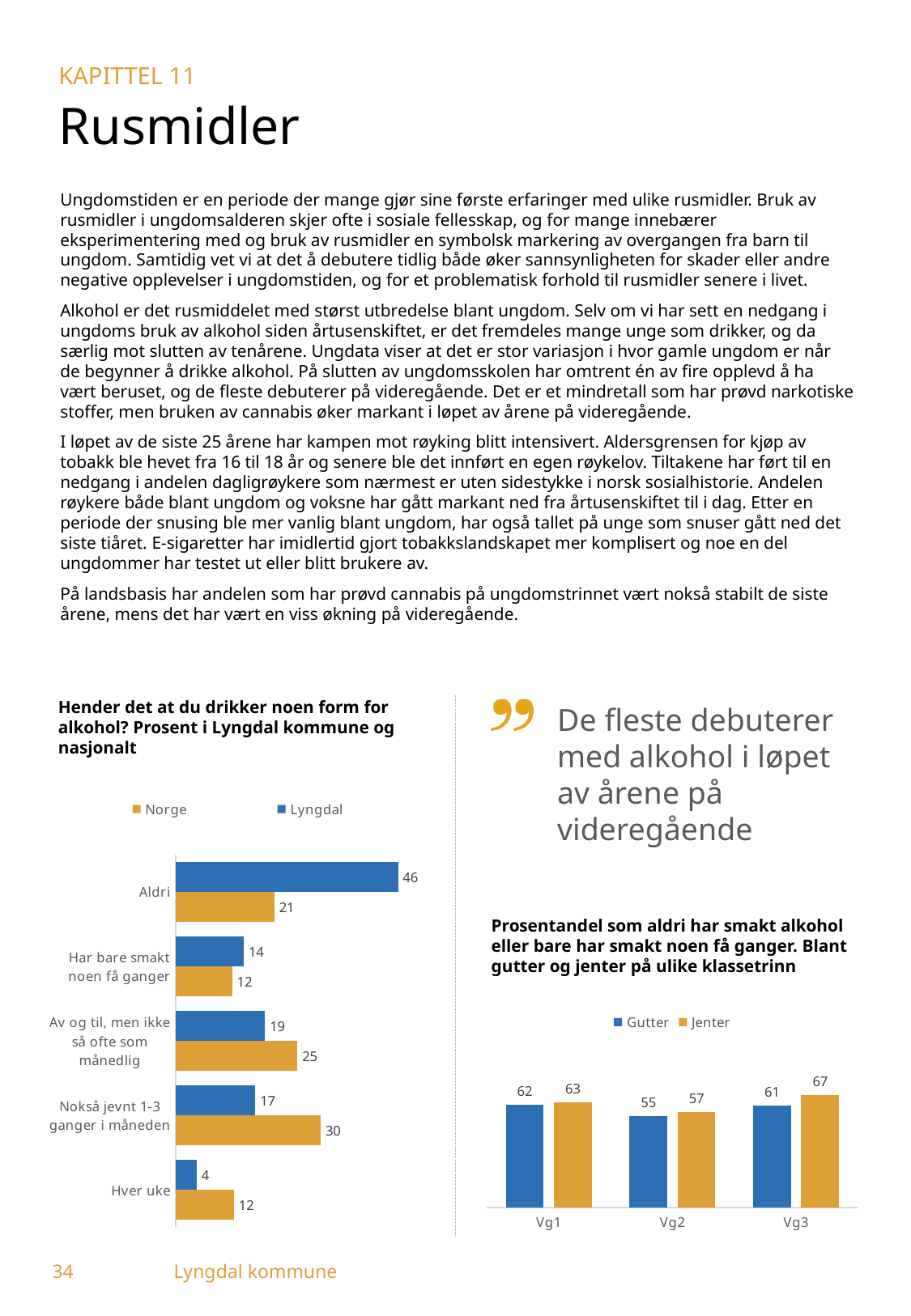
In the chart 'Hender det at du drikker noen form for alkohol?', which category has the lowest value for Lyngdal? Hver uke In the chart 'Prosentandel som aldri har smakt alkohol eller bare har smakt noen få ganger', what is the difference between Jenter and Gutter in Vg3? 6 In the chart 'Prosentandel som aldri har smakt alkohol eller bare har smakt noen få ganger', which class level has the lowest value for Gutter? Vg2 What type of chart is 'Hender det at du drikker noen form for alkohol?'? Bar chart In the chart 'Hender det at du drikker noen form for alkohol?', which colour represents Norge? Orange In the chart 'Prosentandel som aldri har smakt alkohol eller bare har smakt noen få ganger', what is the value for Jenter in Vg3? 67 In the chart 'Hender det at du drikker noen form for alkohol?', which is larger for 'Hver uke': Norge or Lyngdal? Norge In the chart 'Hender det at du drikker noen form for alkohol?', what is the value for Norge in the category 'Nokså jevnt 1-3 ganger i måneden'? 30 How many categories are shown in the chart 'Hender det at du drikker noen form for alkohol?'? 5 How many series does the legend list in the chart 'Prosentandel som aldri har smakt alkohol eller bare har smakt noen få ganger'? 2 In the chart 'Hender det at du drikker noen form for alkohol?', what is the difference between the Lyngdal and Norge values for 'Aldri'? 25 In the chart 'Hender det at du drikker noen form for alkohol?', what is the value for Lyngdal in the category 'Aldri'? 46